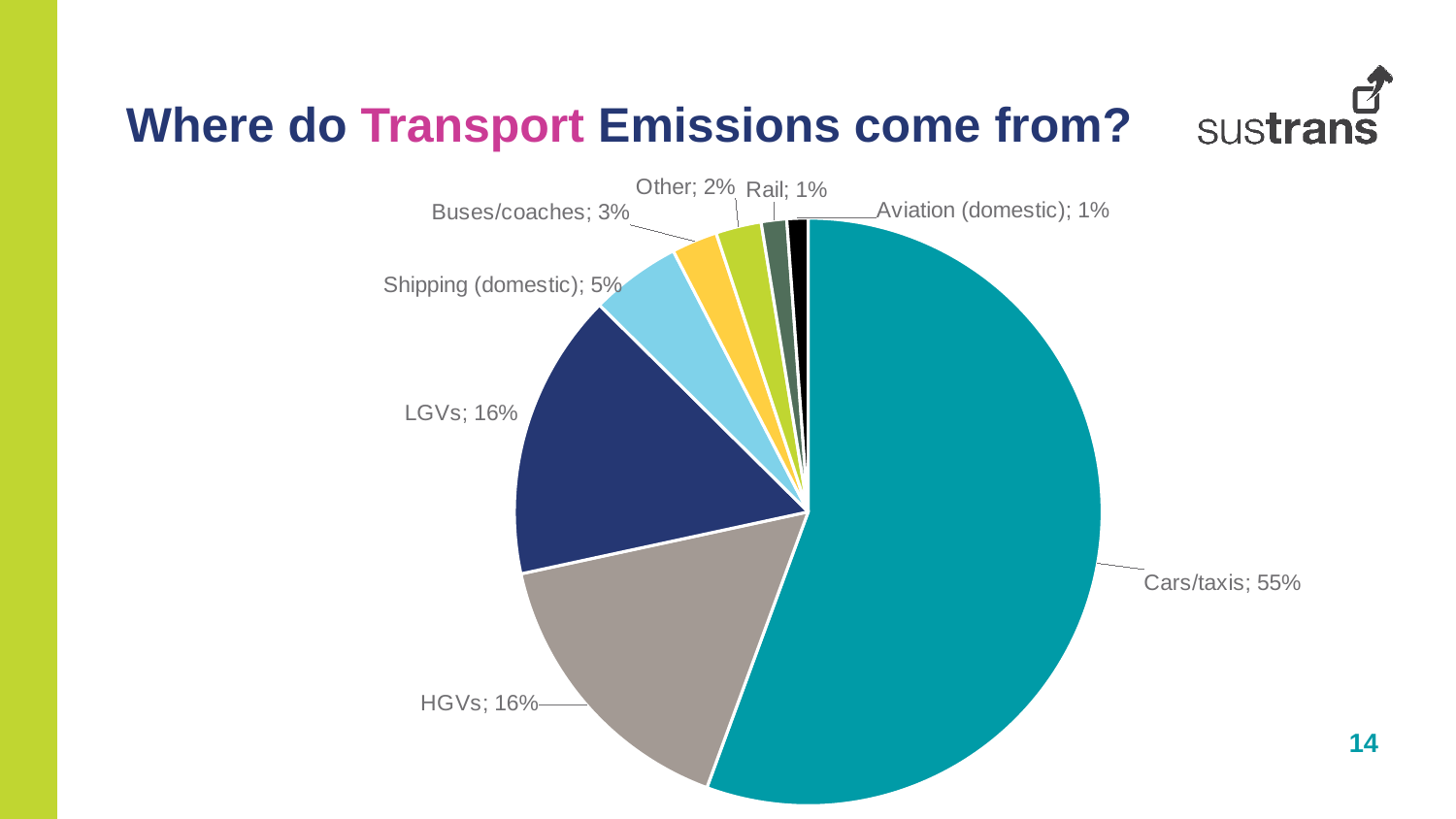
What percentage of the pie is labelled for HGVs? 16% What is the difference between the Cars/taxis share and the LGVs share? 39 percentage points What type of chart is shown on the slide? Pie chart What share of transport emissions comes from Cars/taxis? 55% What is the value labelled for Rail? 1% Which category has the largest slice of the pie? Cars/taxis What is the value shown for Shipping (domestic)? 5% How many categories are shown in the pie chart? 8 What is the title of the slide containing the chart? Where do Transport Emissions come from? What percentage is shown for Buses/coaches? 3% Which is larger, the share for Buses/coaches or the share for Other? Buses/coaches What is the difference between the Shipping (domestic) share and the Other share? 3 percentage points